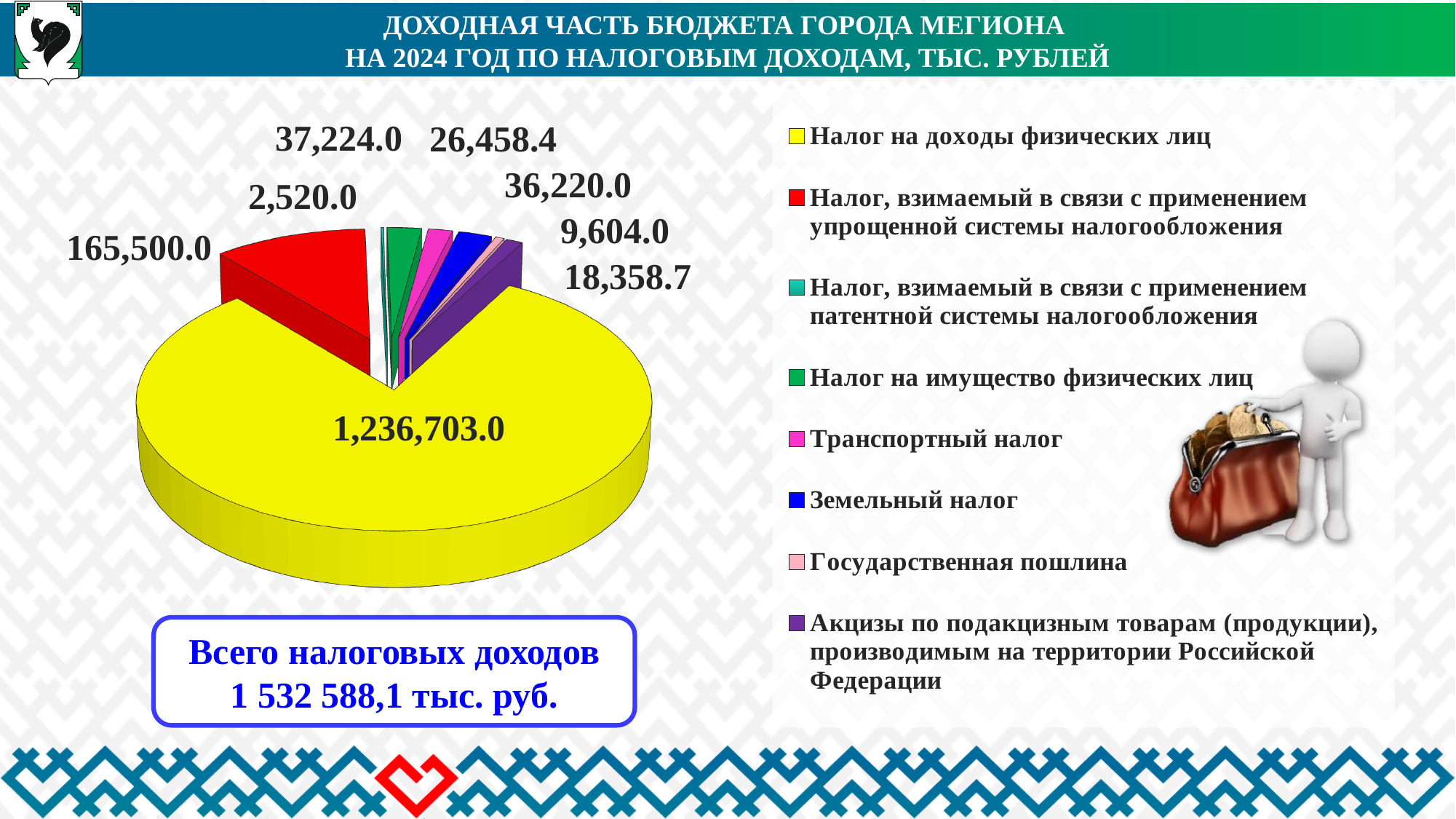
What colour is the slice for Налог на доходы физических лиц? yellow Which is larger: the value for Налог на доходы физических лиц or the value for Налог, взимаемый в связи с применением упрощенной системы налогообложения? Налог на доходы физических лиц How many slices does the pie chart have? 8 Which category has the smallest slice of the pie? Налог, взимаемый в связи с применением патентной системы налогообложения What is the value for Налог, взимаемый в связи с применением патентной системы налогообложения? 2,520.0 What is the difference between the value for Налог на доходы физических лиц and the value for Налог, взимаемый в связи с применением упрощенной системы налогообложения? 1,071,203.0 What kind of chart is shown on the slide? pie chart What total of tax revenues is stated on the slide? 1 532 588,1 тыс. руб. What is the value for Налог на доходы физических лиц? 1,236,703.0 Which category has the largest slice of the pie? Налог на доходы физических лиц What is the value for Налог, взимаемый в связи с применением упрощенной системы налогообложения? 165,500.0 How many entries does the legend list? 8